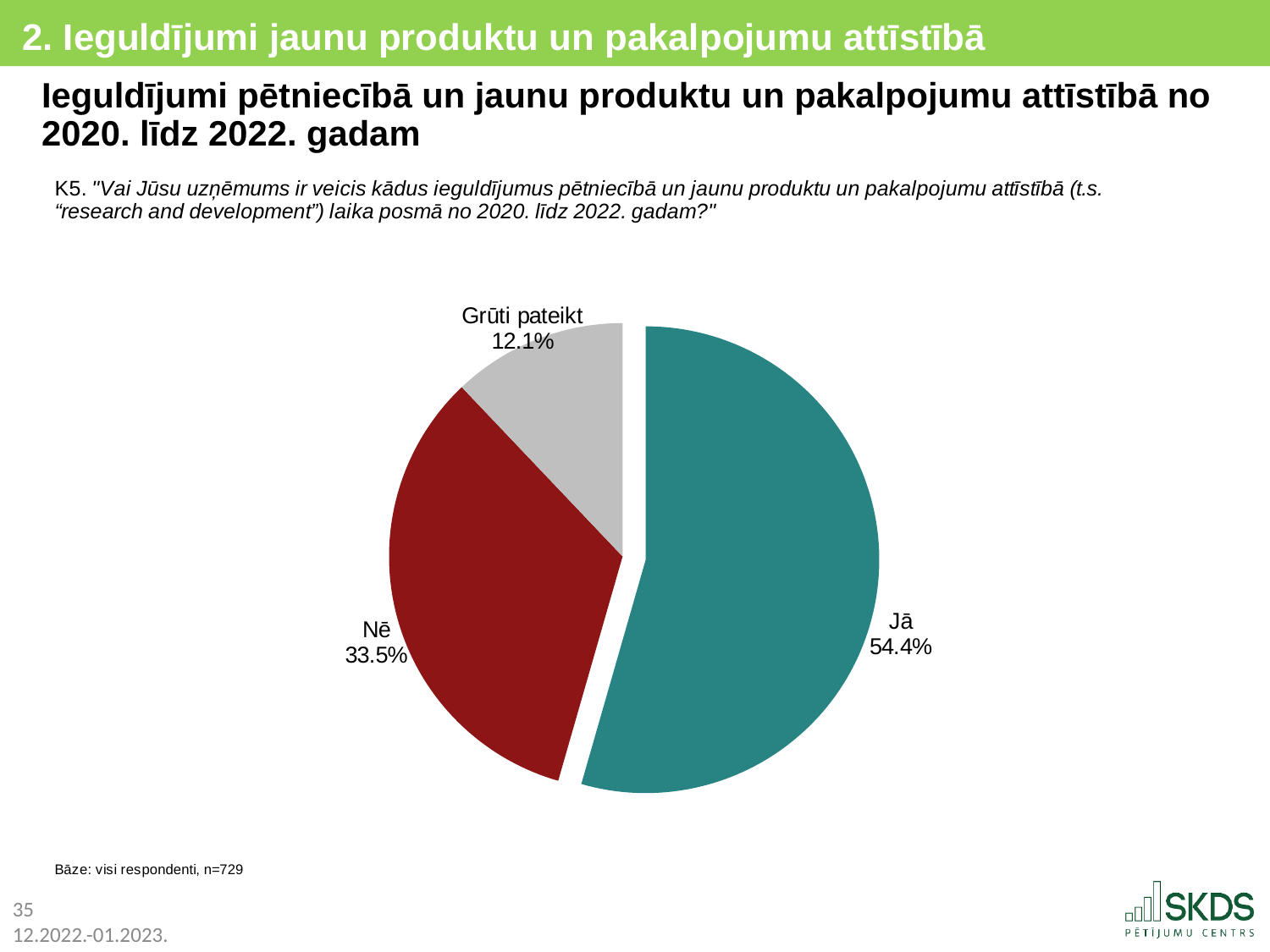
Which category has the smallest slice in the pie chart? Grūti pateikt What is the value for "Grūti pateikt" in the pie chart? 12.1% What colour is the "Nē" slice in the pie chart? dark red What is the value for "Nē" in the pie chart? 33.5% What share of the pie does the "Jā" slice represent? 54.4% What is the value for "Jā" in the pie chart? 54.4% Which is larger in the pie chart, "Nē" or "Grūti pateikt"? Nē How many slices does the pie chart have? 3 What is the difference between the "Jā" and "Nē" values in the pie chart? 20.9% What is the difference between the "Nē" and "Grūti pateikt" values in the pie chart? 21.4% Which category has the largest slice in the pie chart? Jā What type of chart is shown on the slide? pie chart